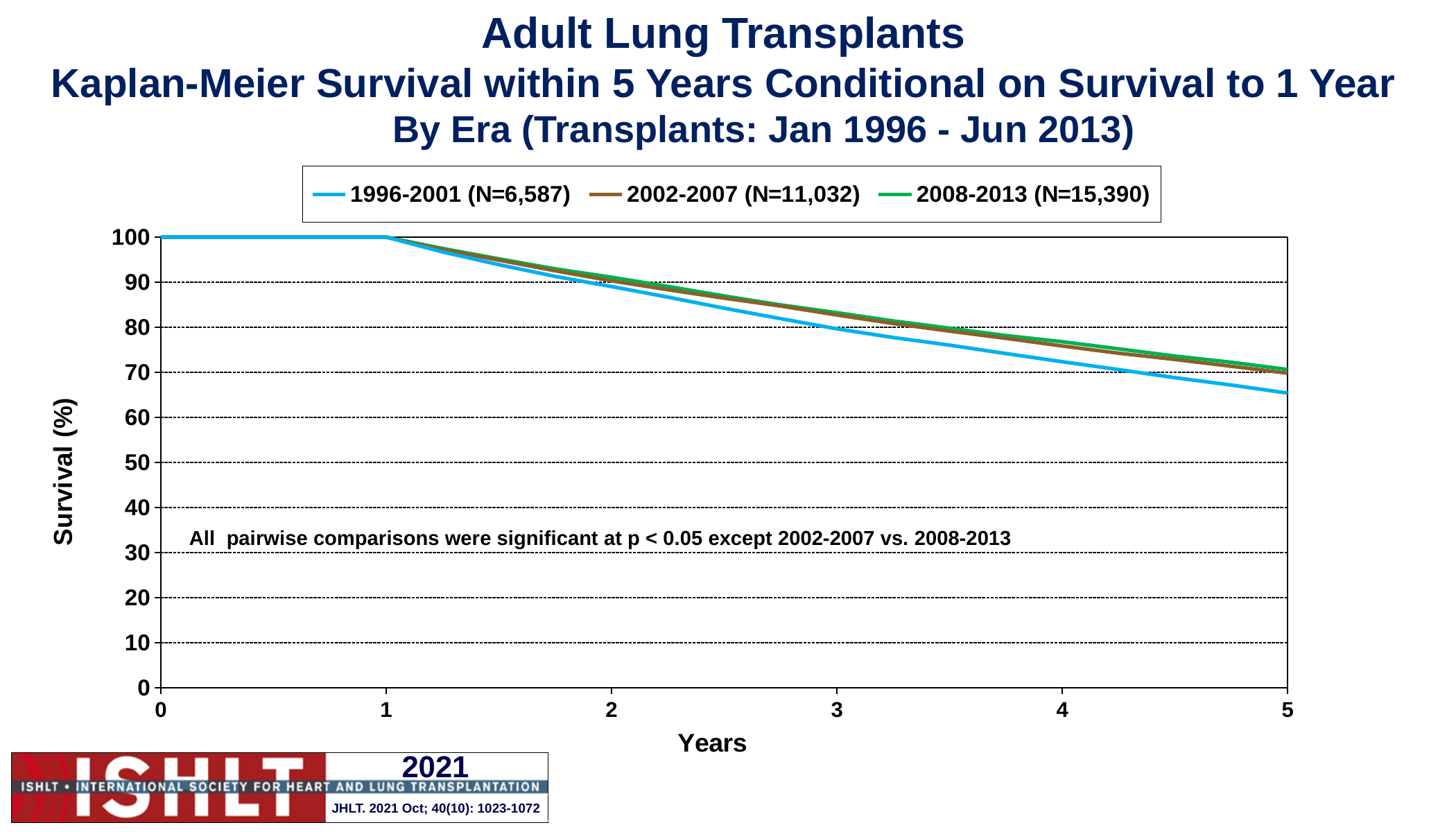
What kind of chart is shown on the slide? line chart What is the label of the y axis? Survival (%) How many series does the legend list? 3 What is the survival value for the 1996-2001 era at year 1? 100 Which era has the lowest survival at year 5? 1996-2001 At year 5, which is higher: survival for the 1996-2001 era or the 2008-2013 era? 2008-2013 What is the N for the 2002-2007 era shown in the legend? 11,032 Is the survival value for the 1996-2001 era at year 2 greater or less than 80? greater Is the survival value for the 1996-2001 era at year 5 greater or less than 70? less Do the survival curves rise or fall between year 1 and year 5? fall Is the survival value for the 1996-2001 era at year 4 greater or less than 80? less